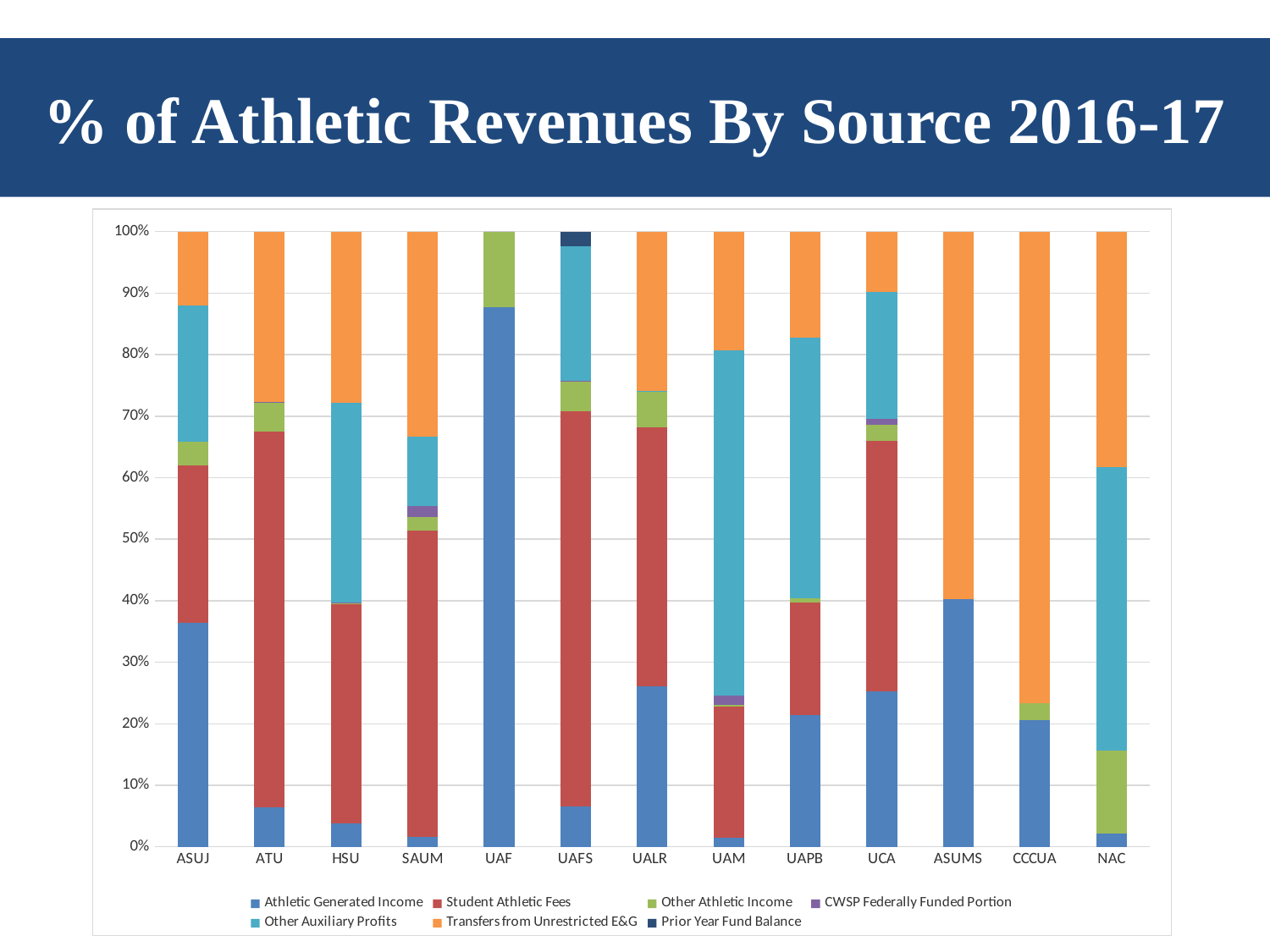
How many series does the chart's legend list? 7 What is the total of the stacked bar for ASUJ? 100% What kind of chart is shown on the slide? Stacked bar chart Is the Athletic Generated Income share for ASUJ greater or less than 30%? greater How many institutions are shown along the x axis of the chart? 13 Is the Other Auxiliary Profits share larger for UAM or for ATU? UAM What is the title of the chart on the slide? % of Athletic Revenues By Source 2016-17 Which institution has the largest share of Athletic Generated Income? UAF Is the Athletic Generated Income share larger for UAF or for ASUMS? UAF Is the Athletic Generated Income share for ASUMS greater or less than 50%? less Which institution has the largest share of Transfers from Unrestricted E&G? CCCUA Is the Athletic Generated Income share for UAF greater or less than 80%? greater